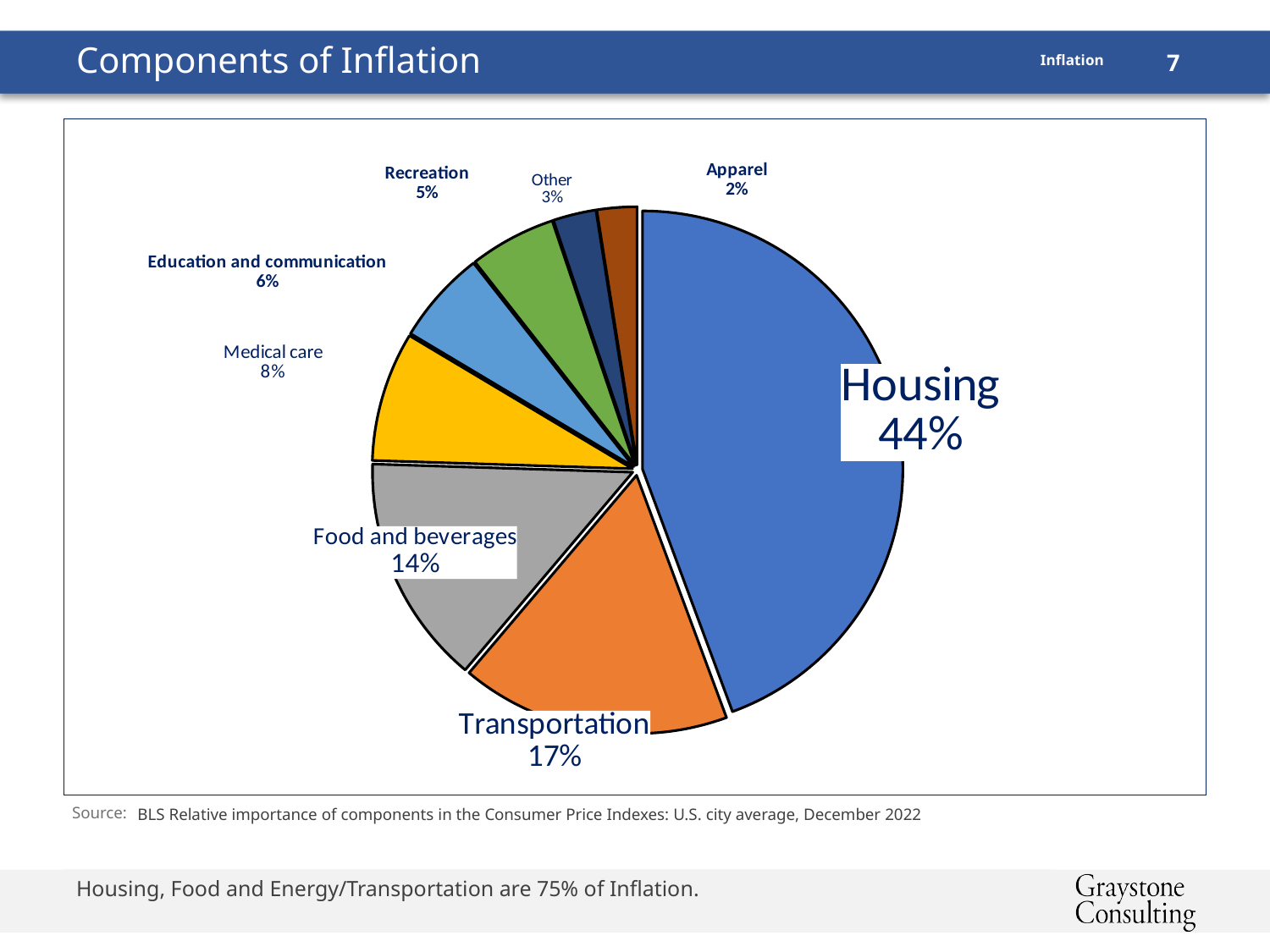
What share of inflation does Housing account for? 44% Which is larger, Recreation or Other? Recreation How many components are shown in the pie chart? 8 Which component has the largest slice of the pie? Housing Which component has the smallest slice of the pie? Apparel What kind of chart is shown on the slide? Pie chart What is the value shown for Food and beverages? 14% What is the value shown for Education and communication? 6% What is the value shown for Transportation? 17% What is the title of the slide containing the chart? Components of Inflation What is the value shown for Medical care? 8% What is the difference between the Housing and Transportation shares? 27%